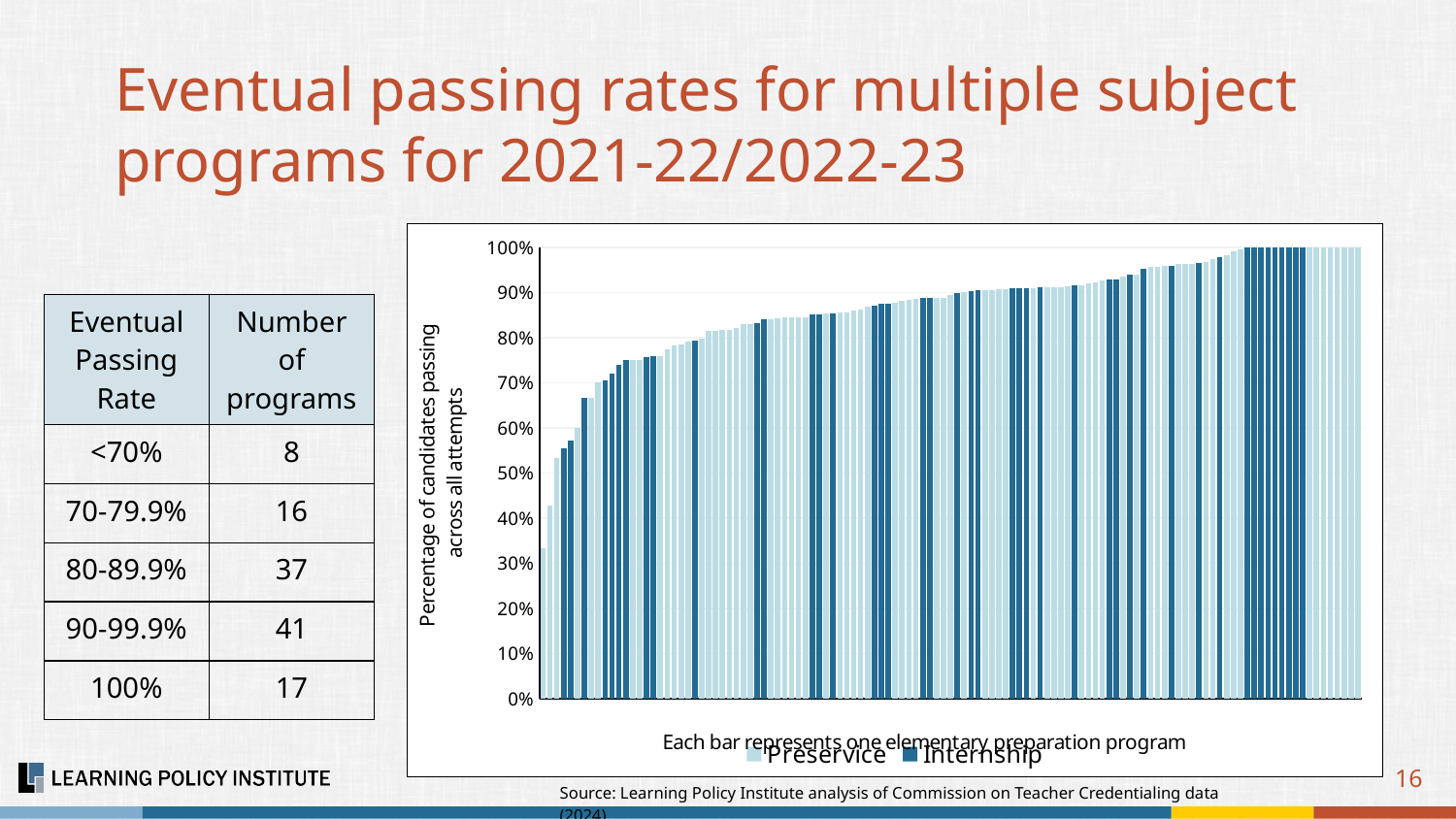
What kind of chart is shown on the slide? bar chart How many series does the chart's legend list? 2 Which bar has the lowest value in the chart, the leftmost or the rightmost? leftmost Do the bar values rise or fall moving from left to right along the x axis? rise Is the value of the rightmost bar in the chart greater or less than 90%? greater Is the value of the leftmost bar in the chart greater or less than 40%? less Which is larger, the value of the leftmost bar or the value of the rightmost bar? the rightmost bar What is the highest value reached by any bar in the chart? 100% What are the two series named in the chart's legend? Preservice and Internship What value do the rightmost bars in the chart reach on the vertical axis? 100% What is the label on the chart's vertical axis? Percentage of candidates passing across all attempts